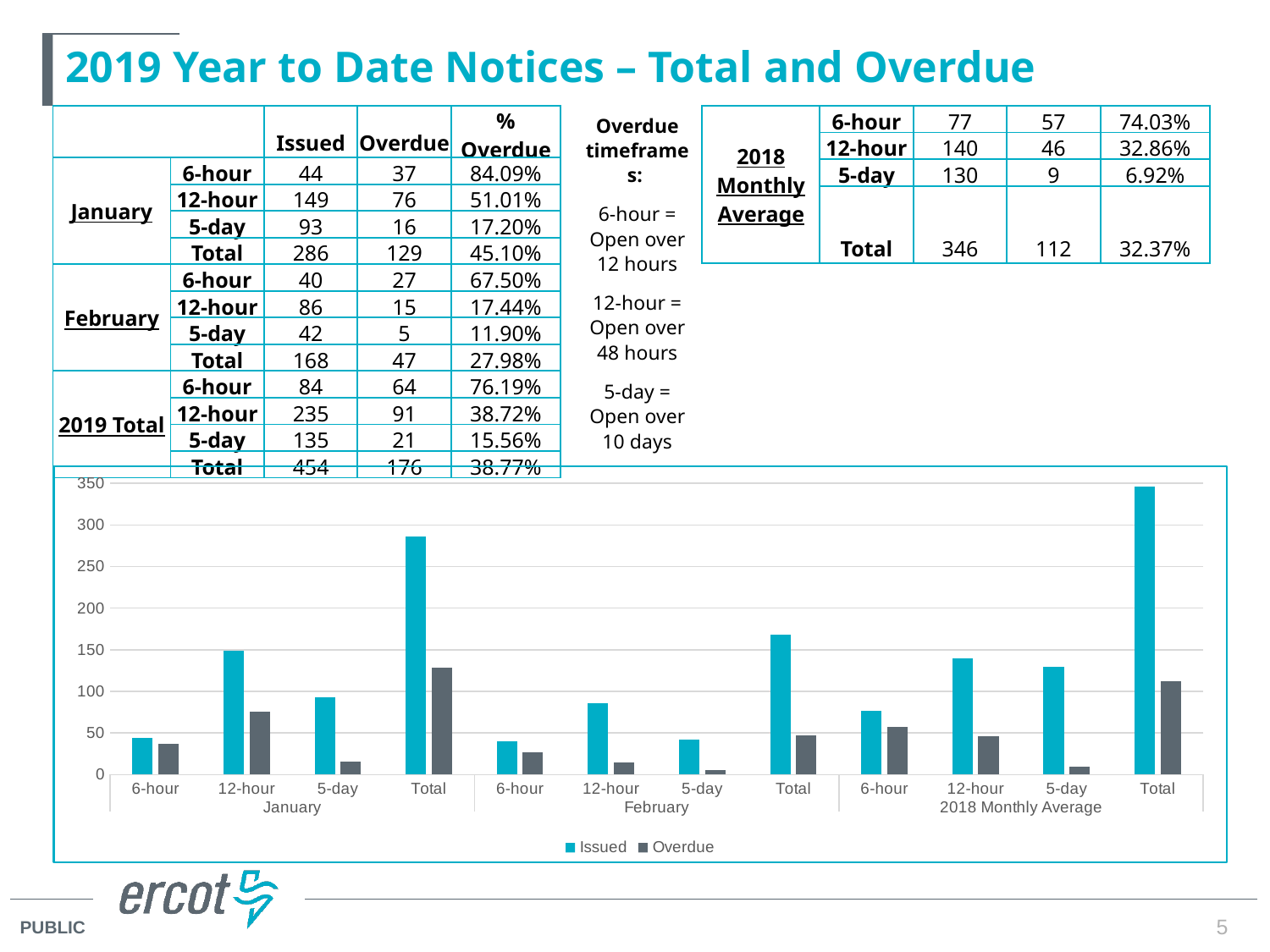
Is the Issued value for the January Total greater or less than 250? greater How many series does the chart legend list? 2 What kind of chart is shown at the bottom of the slide? bar chart Which is larger: the Issued bar for the January Total or the Issued bar for the 2018 Monthly Average Total? 2018 Monthly Average Total Is the Overdue value for the 2018 Monthly Average Total greater or less than 100? greater Which category has the tallest Issued bar in the chart? Total (2018 Monthly Average) Which colour represents the Overdue series in the chart? dark gray Which category has the shortest Overdue bar in the chart? 5-day (February) What is the difference between the Issued and Overdue values for the January Total? 157 Is the Issued value for February 6-hour greater or less than 50? less How many categories are plotted along the x axis of the chart? 12 According to the slide, what is the Issued value for January 6-hour? 44